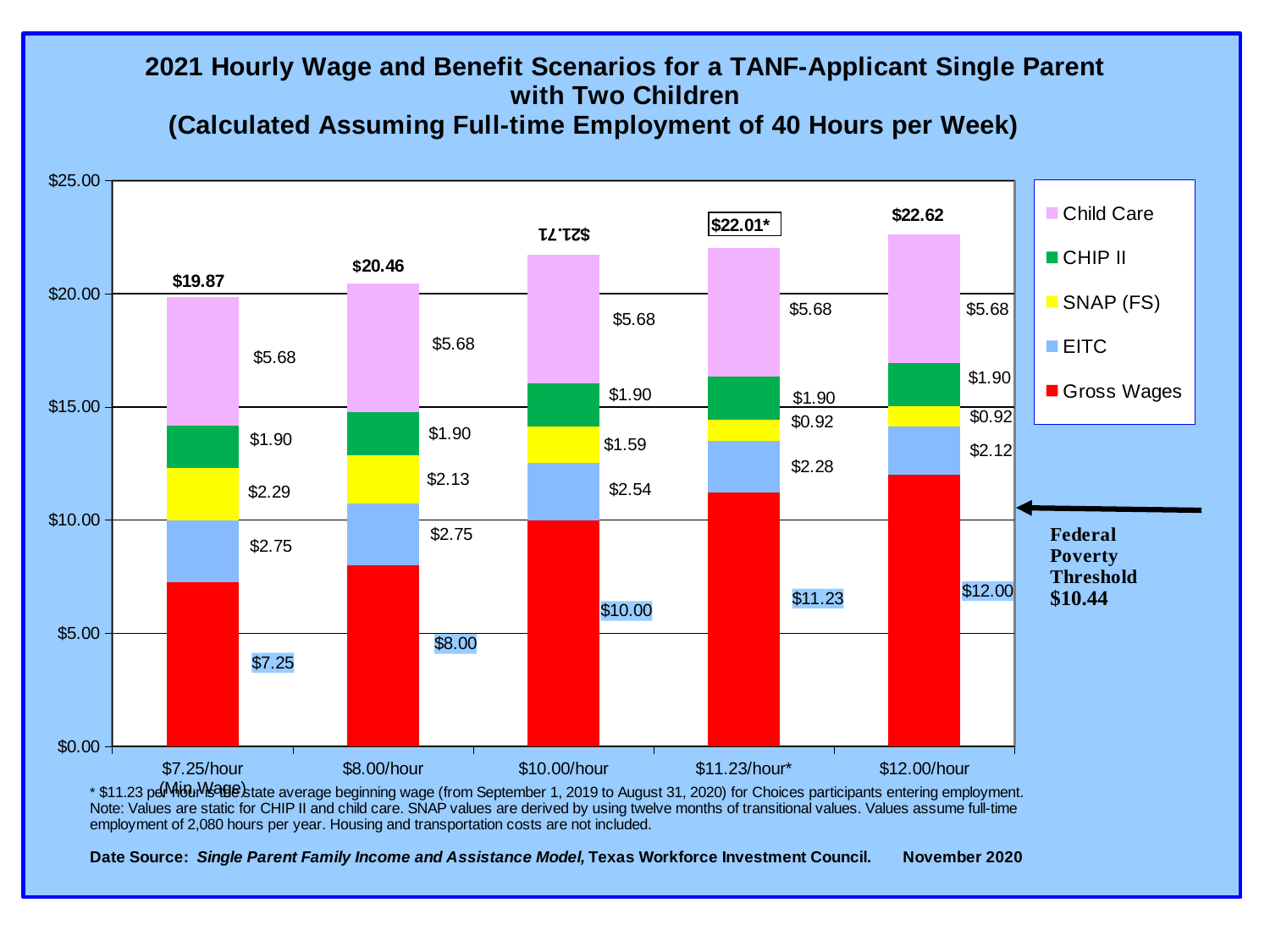
What is the difference between the total for the $12.00/hour scenario and the total for the $7.25/hour scenario? $2.75 Which scenario has the larger EITC value, $7.25/hour or $12.00/hour? $7.25/hour Which scenario has the lowest total hourly wage and benefits? $7.25/hour Which scenario has the highest total hourly wage and benefits? $12.00/hour What is the Child Care value for the $11.23/hour* scenario? $5.68 How many hourly wage scenarios (bars) are plotted? 5 What is the total of the stacked bar for the $12.00/hour scenario? $22.62 How many series does the legend list? 5 What is the EITC value for the $10.00/hour scenario? $2.54 What Federal Poverty Threshold value is marked on the chart? $10.44 What is the SNAP (FS) value for the $8.00/hour scenario? $2.13 What kind of chart is shown on the slide? stacked bar chart